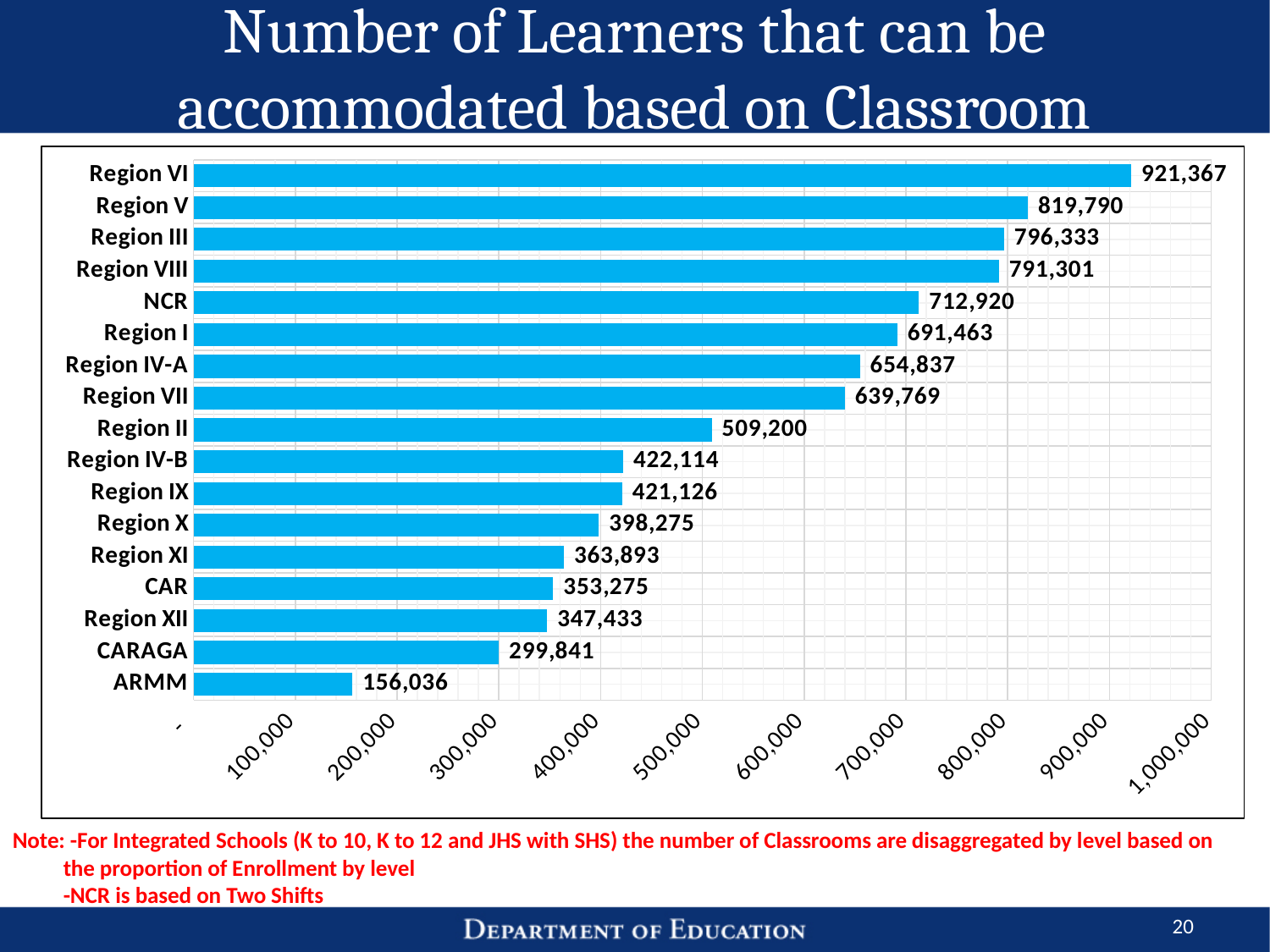
What is the difference between the values for CARAGA and ARMM? 143,805 What is the difference between the values for Region VI and Region V? 101,577 What is the title of the slide? Number of Learners that can be accommodated based on Classroom What is the number of learners that can be accommodated in NCR? 712,920 Which has a larger value, Region I or Region IV-A? Region I How many regions are shown in the chart? 17 What is the number of learners that can be accommodated in CARAGA? 299,841 Which region has the highest number of learners that can be accommodated? Region VI What kind of chart is shown on the slide? bar chart Which region has the lowest number of learners that can be accommodated? ARMM Is the value for Region II greater or less than 500,000? greater What is the number of learners that can be accommodated in Region VI? 921,367